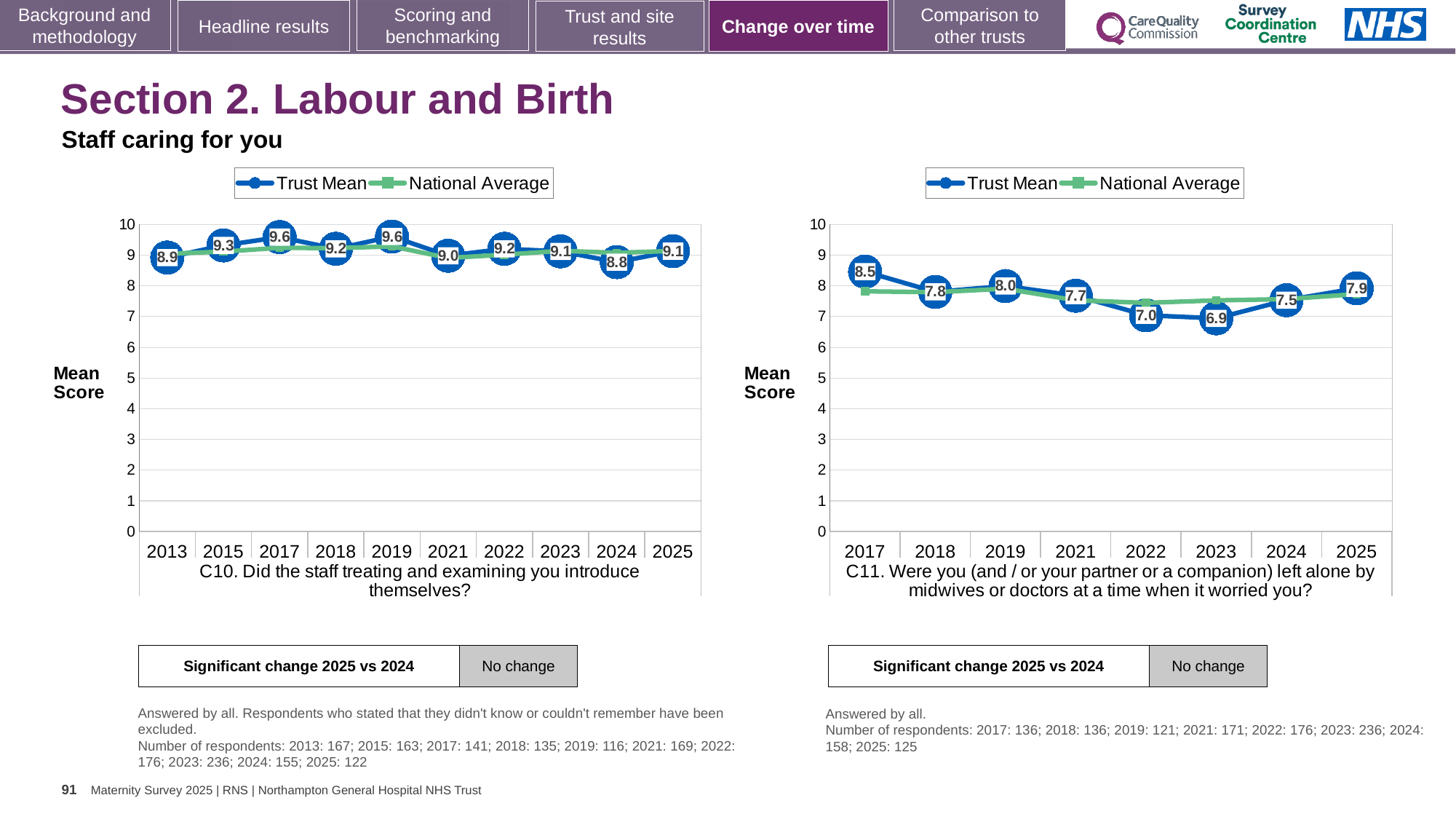
In the C11 chart (right), which year has the lowest Trust Mean? 2023 In the C10 chart (left), what is the difference between the Trust Mean in 2017 and in 2024? 0.8 In the C11 chart (right), is the Trust Mean higher in 2025 or in 2024? 2025 In the C10 chart (left), what is the Trust Mean for 2025? 9.1 In the C11 chart (right), what is the Trust Mean for 2022? 7.0 How many series does the legend of the C11 chart (right) list? 2 What type of chart is the C10 chart (left)? Line chart In the C10 chart (left), which year has the lowest Trust Mean? 2024 In the C10 chart (left), how many years are shown on the x axis? 10 In the C11 chart (right), which year has the highest Trust Mean? 2017 In the C11 chart (right), what is the difference between the Trust Mean in 2017 and in 2023? 1.6 In the C10 chart (left), what is the Trust Mean for 2013? 8.9